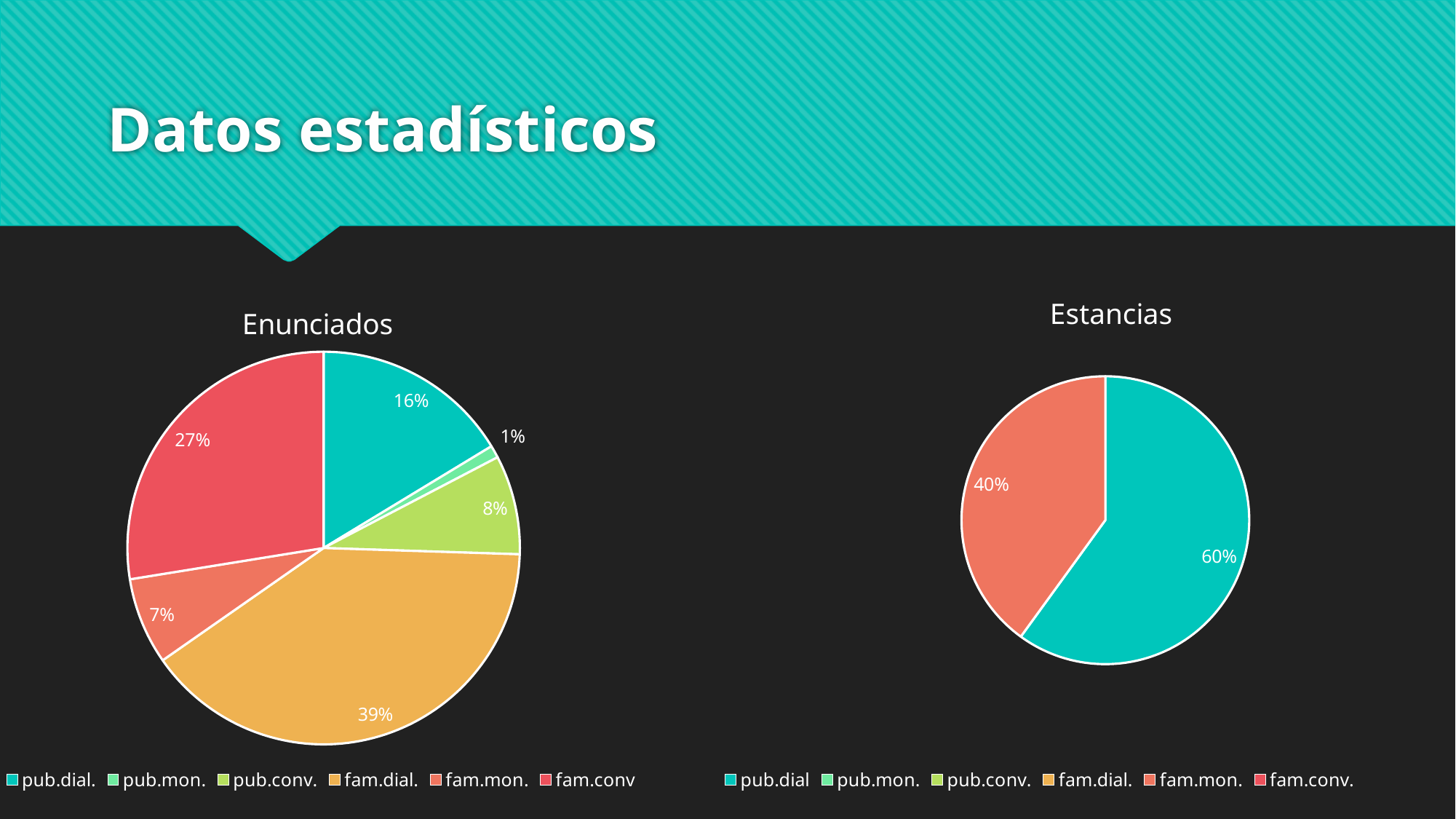
In the Enunciados chart, which category has the smallest slice? pub.mon. In the Enunciados chart, which category has the largest slice? fam.dial. How many entries does the legend of the Enunciados chart list? 6 In the Estancias chart, what is the difference between the two slices shown? 20% In the Enunciados chart, what is the difference between the fam.dial. and fam.conv shares? 12% In the Estancias chart, what share does pub.dial have? 60% What type of chart is the Enunciados chart? Pie chart In the Enunciados chart, what share does fam.dial. have? 39% In the Enunciados chart, what share does pub.dial. have? 16% How many slices are visible in the Estancias chart? 2 In the Enunciados chart, which is larger, pub.conv. or fam.mon.? pub.conv. In the Enunciados chart, what share does fam.conv have? 27%